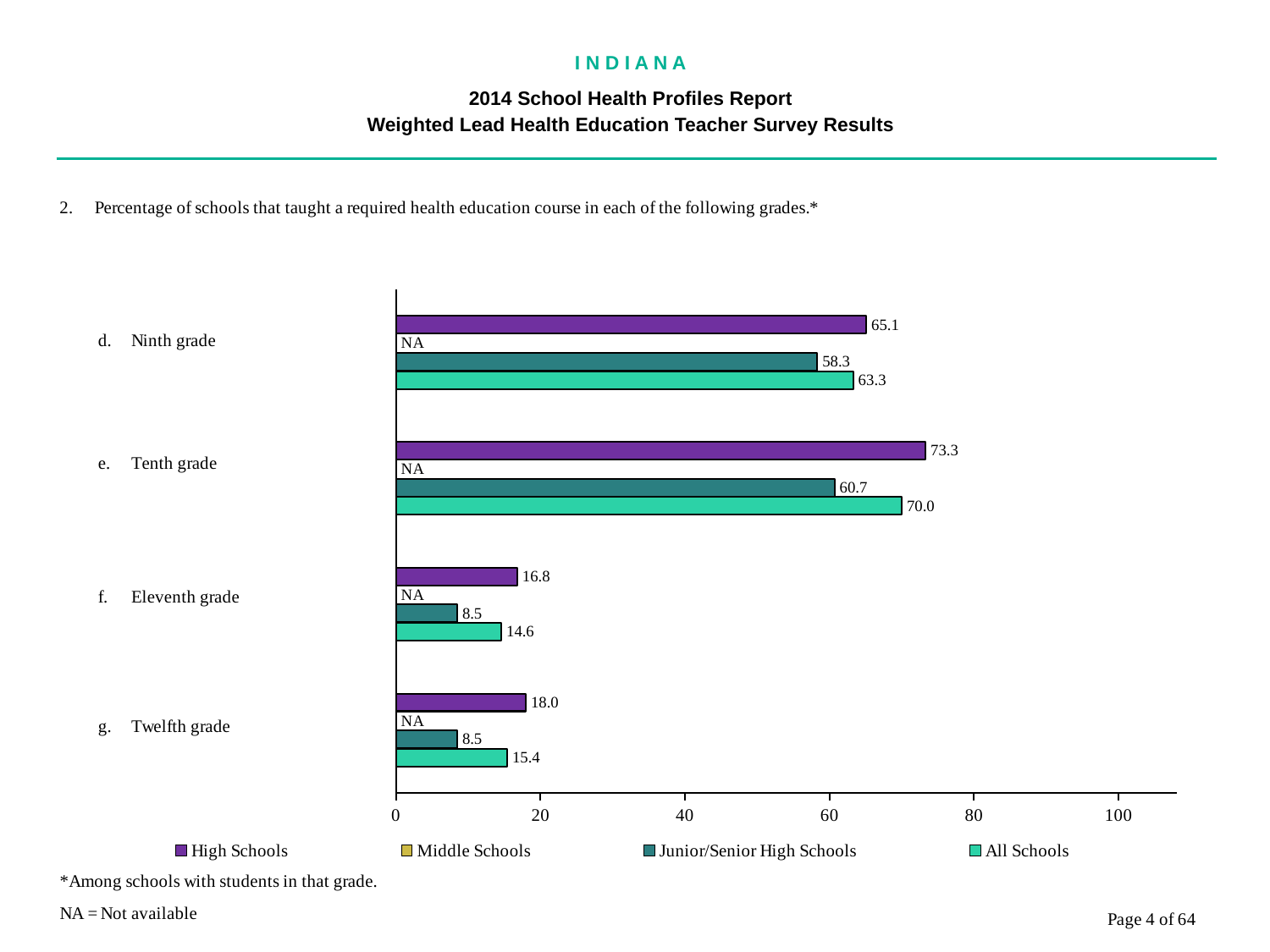
How many grade categories are shown in the chart? 4 Which grade has the highest value for High Schools? Tenth grade Which grade has the lowest value for All Schools? Eleventh grade Is the All Schools value for Tenth grade greater or less than 60? greater How many series does the legend list? 4 What is the value for All Schools for Ninth grade? 63.3 What value is shown for Middle Schools in Twelfth grade? NA Which is larger for Twelfth grade: the High Schools value or the All Schools value? High Schools What is the difference between the High Schools and Junior/Senior High Schools values for Tenth grade? 12.6 What kind of chart is shown on the slide? bar chart What is the value for Junior/Senior High Schools for Eleventh grade? 8.5 What percentage of High Schools taught a required health education course in Tenth grade? 73.3